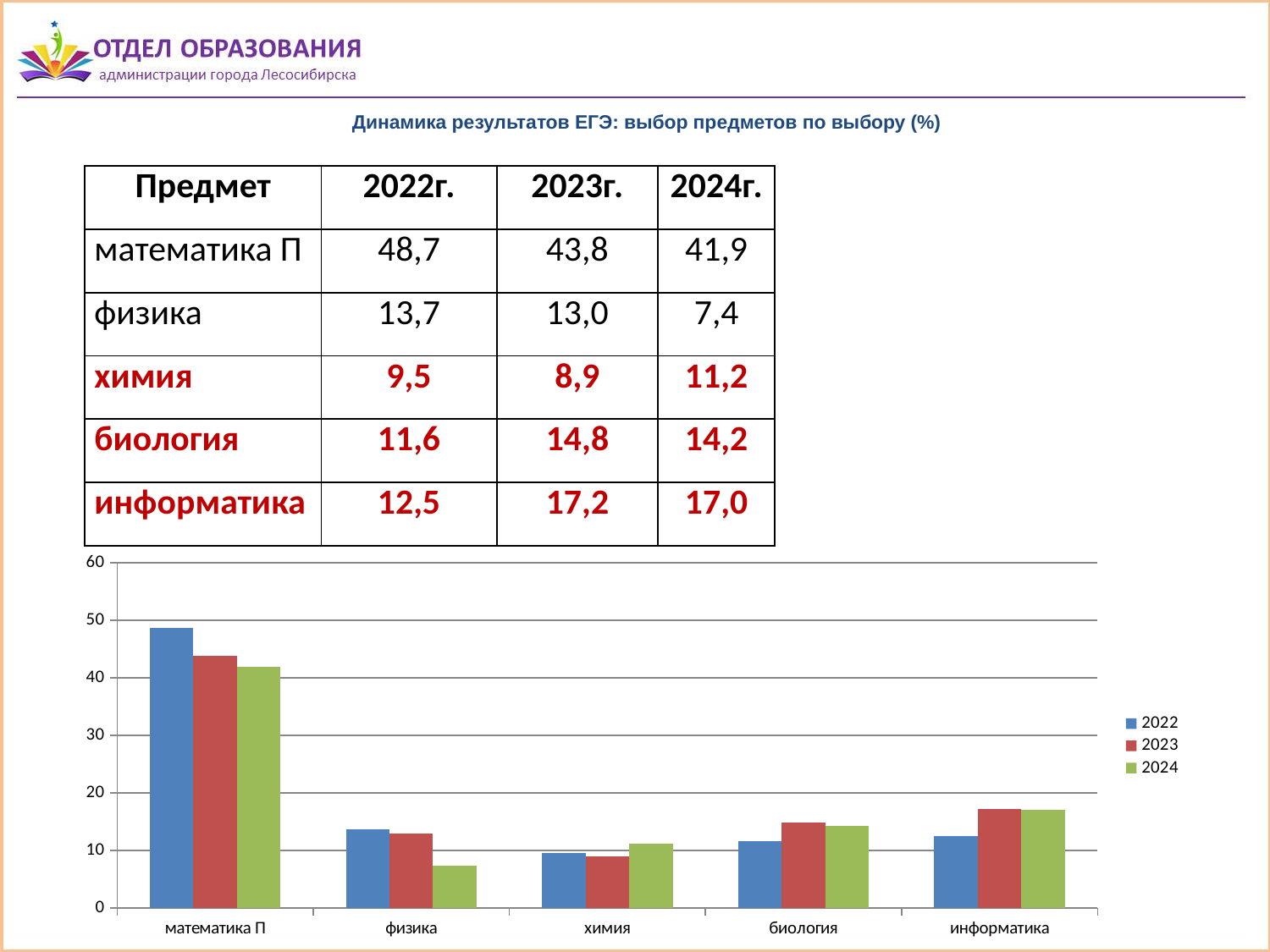
Do the values for физика rise or fall from 2022 to 2024? fall Which subject has the lowest value for 2024? физика What is the value for математика П in 2022? 48,7 What is the value for информатика in 2023? 17,2 How many subject categories are shown on the x axis of the chart? 5 Which colour represents the 2024 series in the chart? green What is the difference between the 2022 and 2024 values for математика П? 6,8 How many series does the chart legend list? 3 Is the 2022 value for математика П greater or less than 40? greater Which subject has the highest value for 2022? математика П Which is larger for биология: the 2023 value or the 2022 value? 2023 What kind of chart is shown on the slide? bar chart